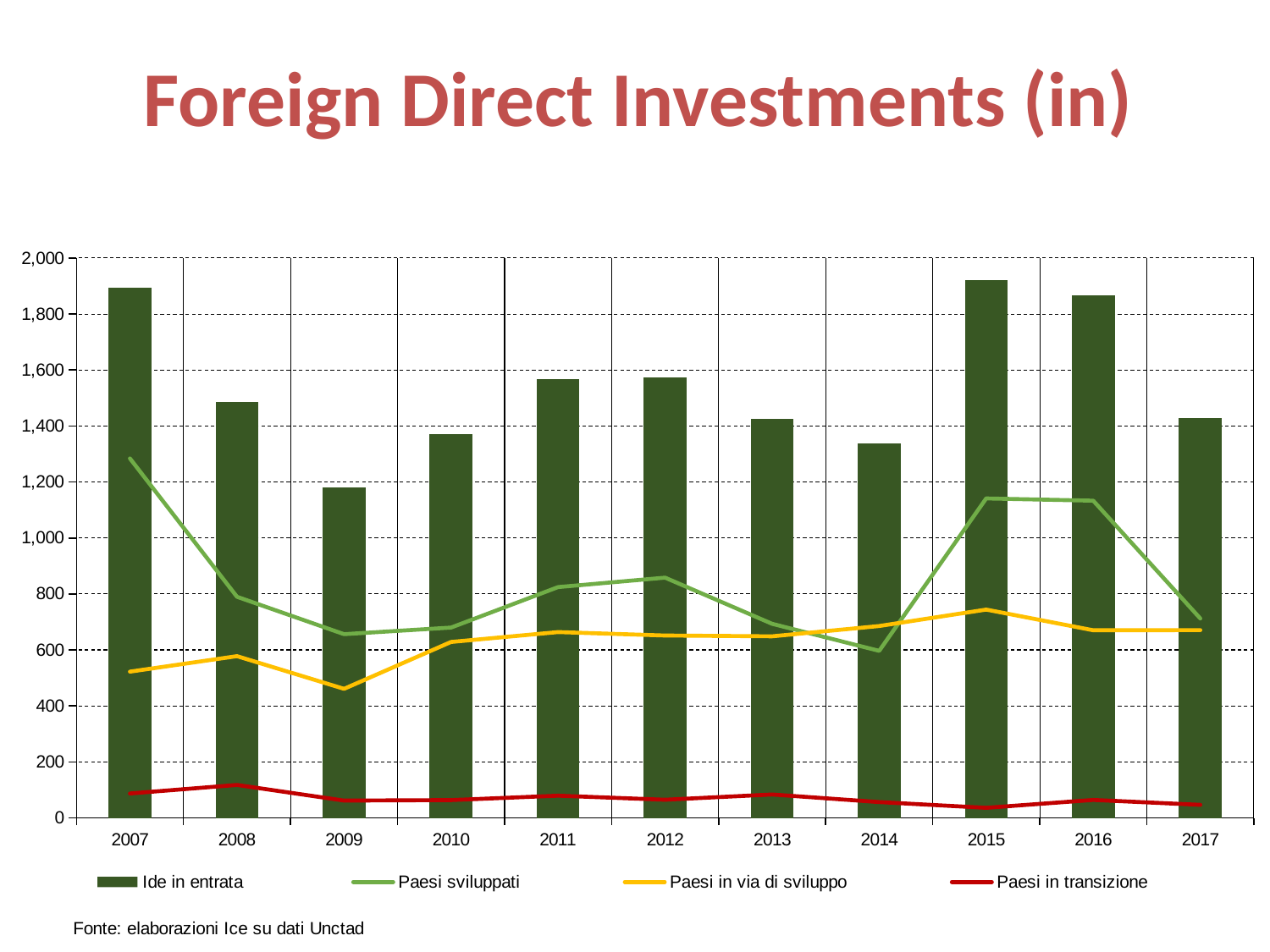
How many years are shown on the x axis? 11 What kind of chart is shown on the slide? A combined bar and line chart Which year has the lowest value for Paesi in via di sviluppo? 2009 Which year has the highest value for Paesi sviluppati? 2007 Is the value for Ide in entrata in 2009 greater or less than 1,200? less Which year has the lowest bar for Ide in entrata? 2009 Which year has the highest value for Paesi in via di sviluppo? 2015 Does the Paesi sviluppati line rise or fall from 2007 to 2009? fall Is the value for Paesi in via di sviluppo in 2009 greater or less than 500? less How many series does the legend list? 4 Is the value for Ide in entrata in 2007 greater or less than 1,800? greater Which is larger in 2014: Paesi sviluppati or Paesi in via di sviluppo? Paesi in via di sviluppo